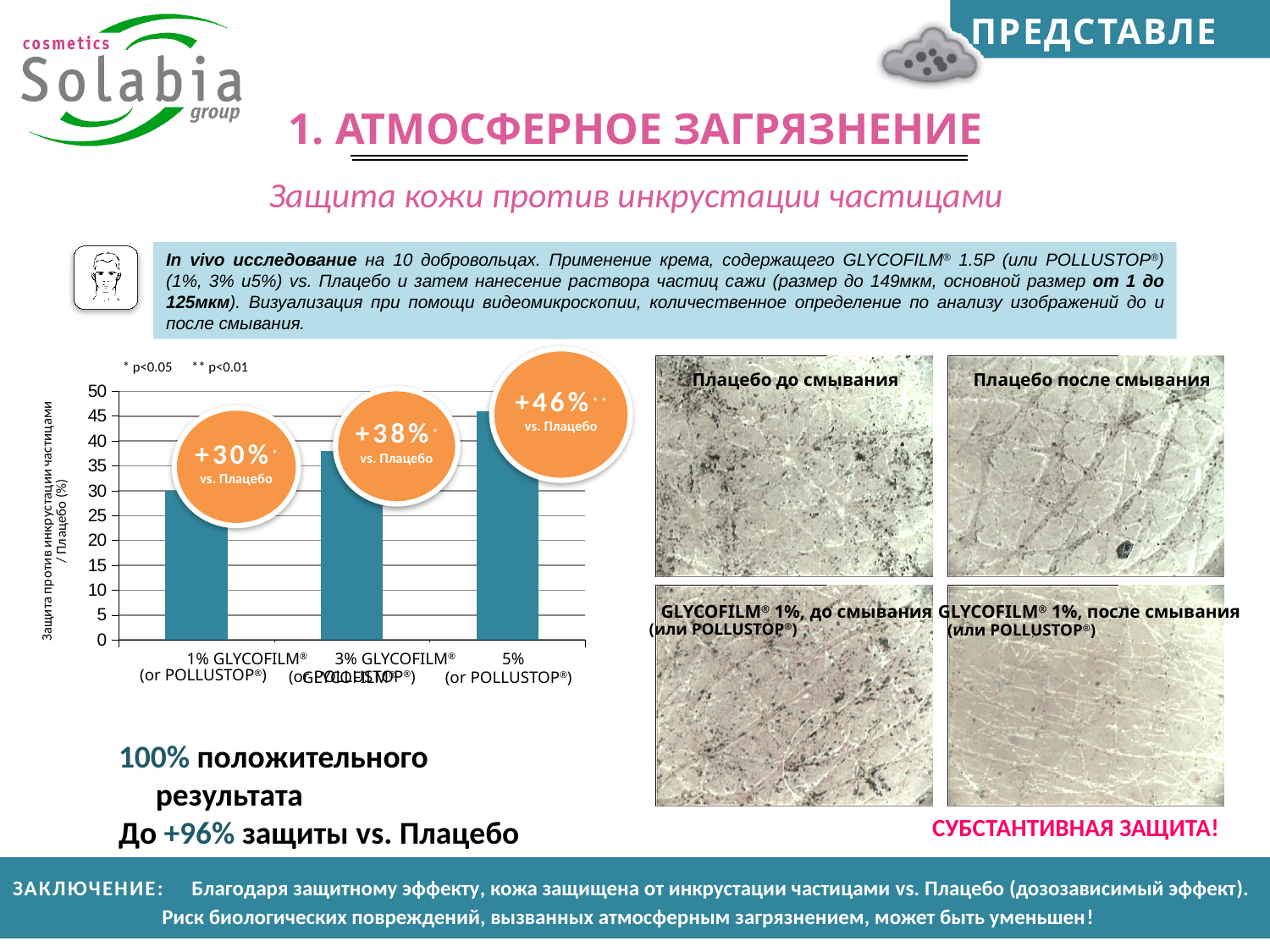
Which concentration has the lowest bar? 1% GLYCOFILM What percentage vs. Placebo is shown in the callout for the 5% bar? +46% What percentage vs. Placebo is shown in the callout for the 1% GLYCOFILM bar? +30% Do the bar values rise or fall as the concentration increases from 1% to 5%? rise How many bars does the chart contain? 3 Is the value for the 1% GLYCOFILM bar greater or less than 35? less Which concentration has the highest bar? 5% What is the maximum value shown on the vertical axis of the chart? 50 What kind of chart is shown on the left of the slide? bar chart Is the value for the 5% bar greater or less than 40? greater What percentage vs. Placebo is shown in the callout for the 3% GLYCOFILM bar? +38% Which bar is taller, 3% GLYCOFILM or 1% GLYCOFILM? 3% GLYCOFILM